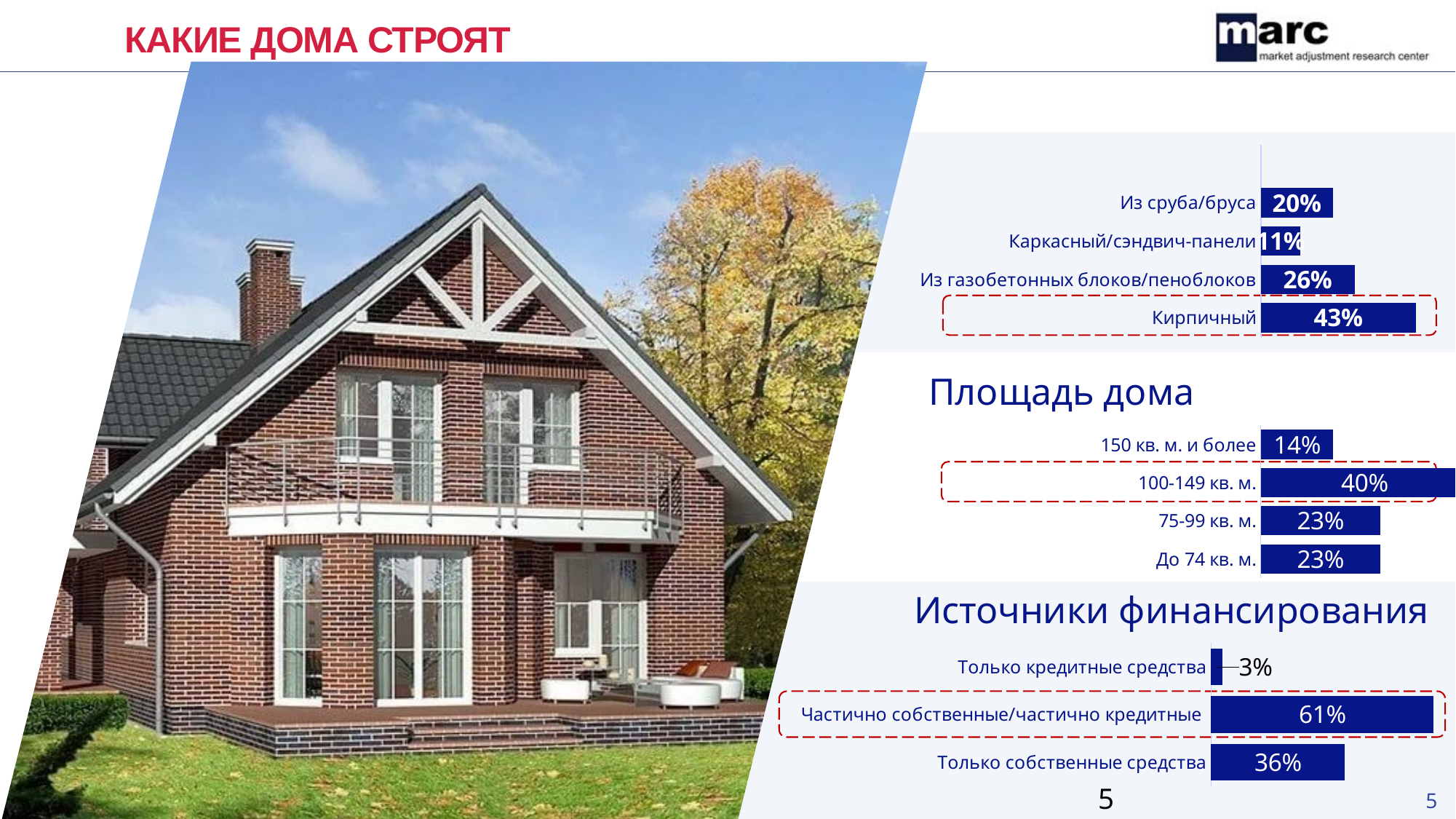
How many categories does the top chart on the right show? 4 In the chart titled Источники финансирования, what is the value for Только собственные средства? 36% In the chart titled Площадь дома, which is larger: 150 кв. м. и более or 75-99 кв. м.? 75-99 кв. м. In the top chart on the right, what is the difference between Кирпичный and Из сруба/бруса? 23% In the chart titled Источники финансирования, which category has the lowest value? Только кредитные средства What kind of chart is the chart titled Источники финансирования? Bar chart In the chart titled Источники финансирования, what is the difference between Частично собственные/частично кредитные and Только собственные средства? 25% How many categories does the chart titled Площадь дома show? 4 In the top chart on the right, which category has the lowest value? Каркасный/сэндвич-панели In the chart titled Площадь дома, what is the value for 100-149 кв. м.? 40% In the chart titled Площадь дома, which category has the highest value? 100-149 кв. м. In the top chart on the right, what is the value for Кирпичный? 43%